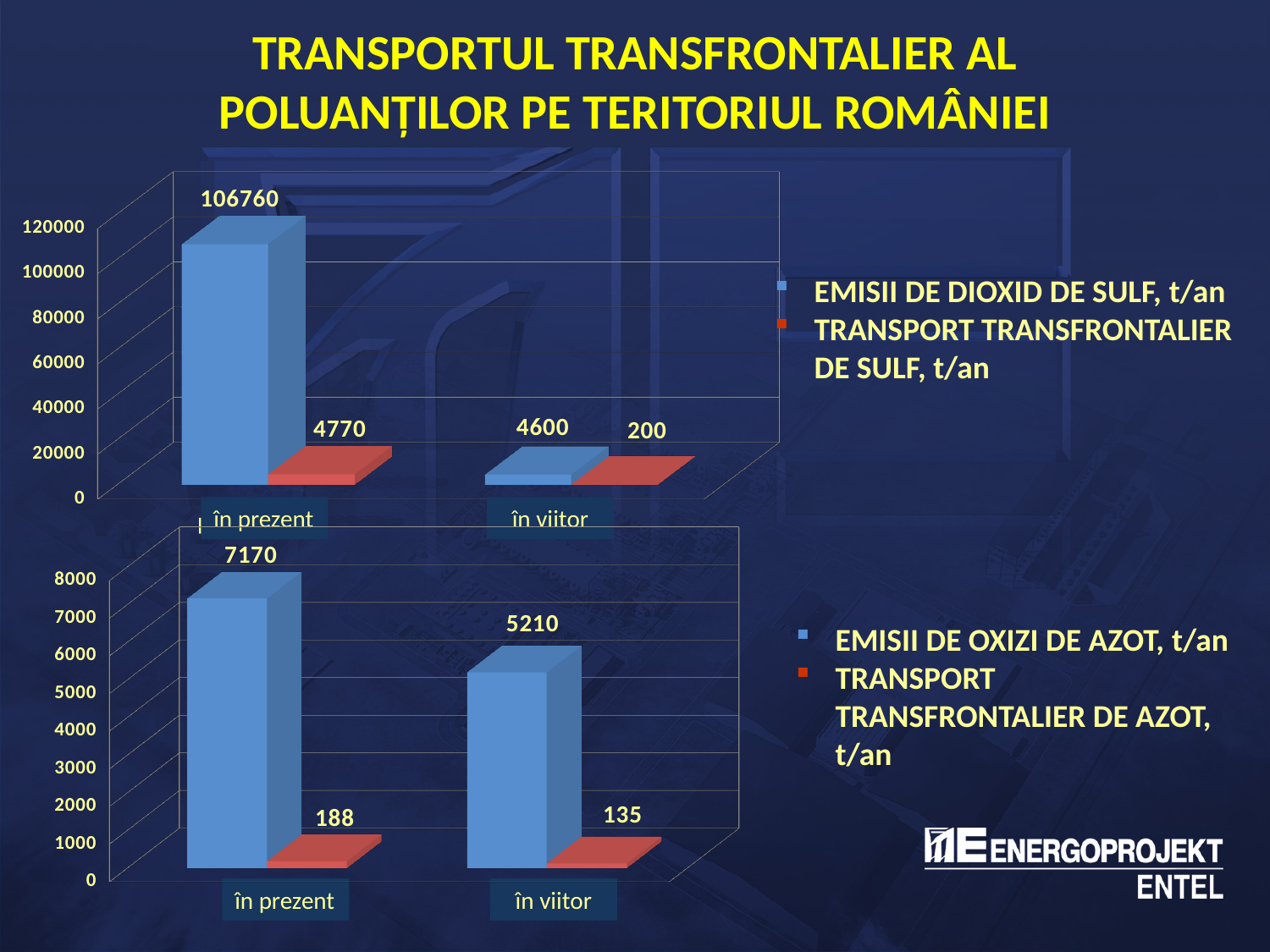
In the top chart, what is the value of EMISII DE DIOXID DE SULF, t/an for în prezent? 106760 In the top chart, what is the difference between EMISII DE DIOXID DE SULF, t/an for în prezent and for în viitor? 102160 In the top chart, what is the value of EMISII DE DIOXID DE SULF, t/an for în viitor? 4600 In the bottom chart, what is the value of TRANSPORT TRANSFRONTALIER DE AZOT, t/an for în prezent? 188 In the bottom chart, does EMISII DE OXIZI DE AZOT, t/an rise or fall from în prezent to în viitor? fall How many series does the legend of the bottom chart list? 2 What kind of chart is the top chart? bar chart In the top chart, which category has the highest value for TRANSPORT TRANSFRONTALIER DE SULF, t/an? în prezent In the top chart, what is the value of TRANSPORT TRANSFRONTALIER DE SULF, t/an for în viitor? 200 In the bottom chart, what is the difference between EMISII DE OXIZI DE AZOT, t/an for în prezent and for în viitor? 1960 In the bottom chart, which is larger: TRANSPORT TRANSFRONTALIER DE AZOT, t/an for în prezent or for în viitor? în prezent In the bottom chart, what is the value of EMISII DE OXIZI DE AZOT, t/an for în viitor? 5210